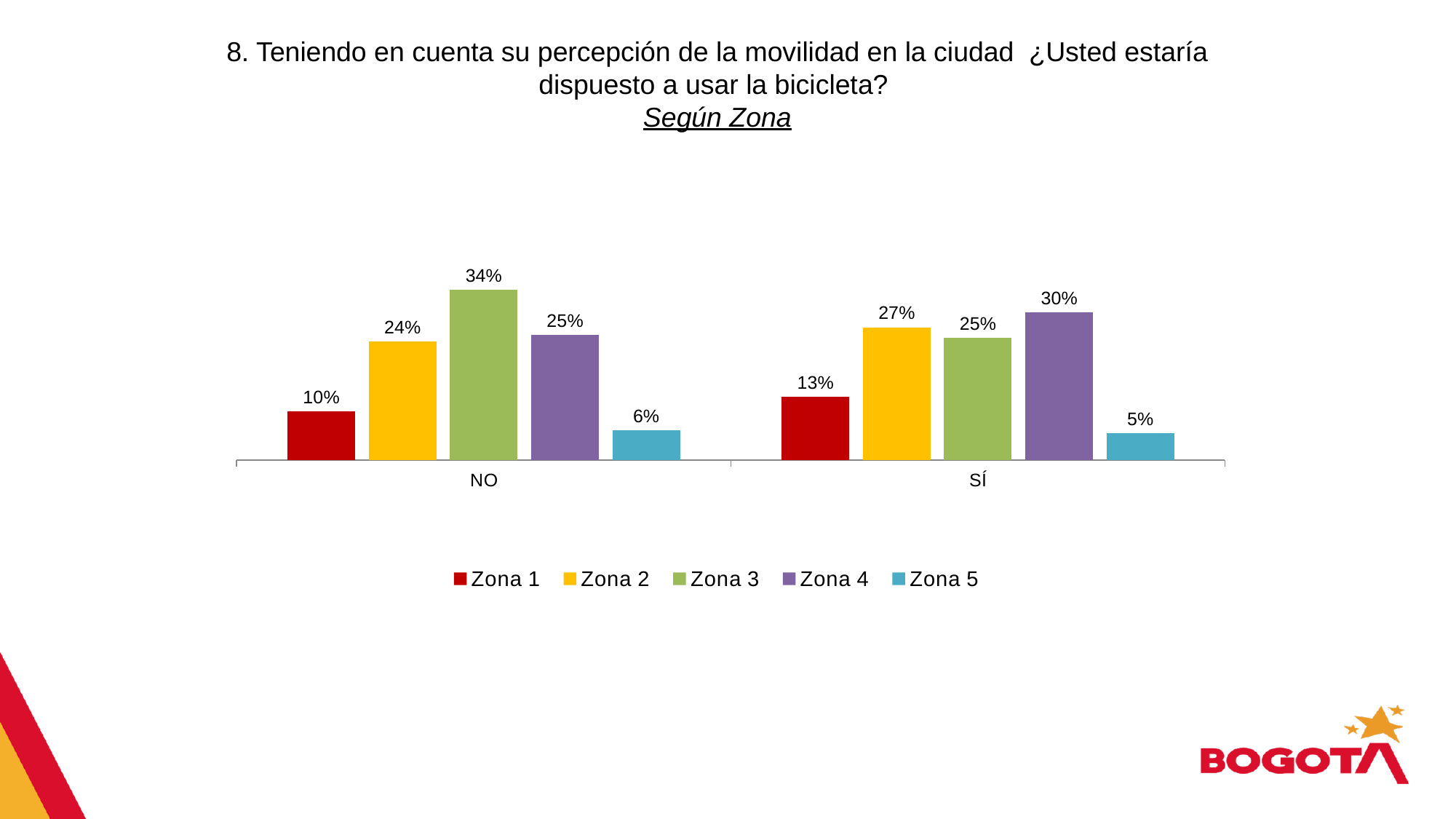
What is the value for Zona 1 in the SÍ category? 13% Which is larger: Zona 2 in the SÍ category or Zona 2 in the NO category? Zona 2 in the SÍ category What kind of chart is shown on the slide? Bar chart What is the value for Zona 5 in the SÍ category? 5% What is the value for Zona 3 in the NO category? 34% What is the value for Zona 2 in the NO category? 24% How many series does the legend list? 5 Which zone has the highest value in the SÍ category? Zona 4 How many categories are shown on the x axis? 2 What colour represents Zona 4 in the chart? Purple What is the difference between Zona 3 and Zona 1 in the NO category? 24% Which zone has the lowest value in the NO category? Zona 5